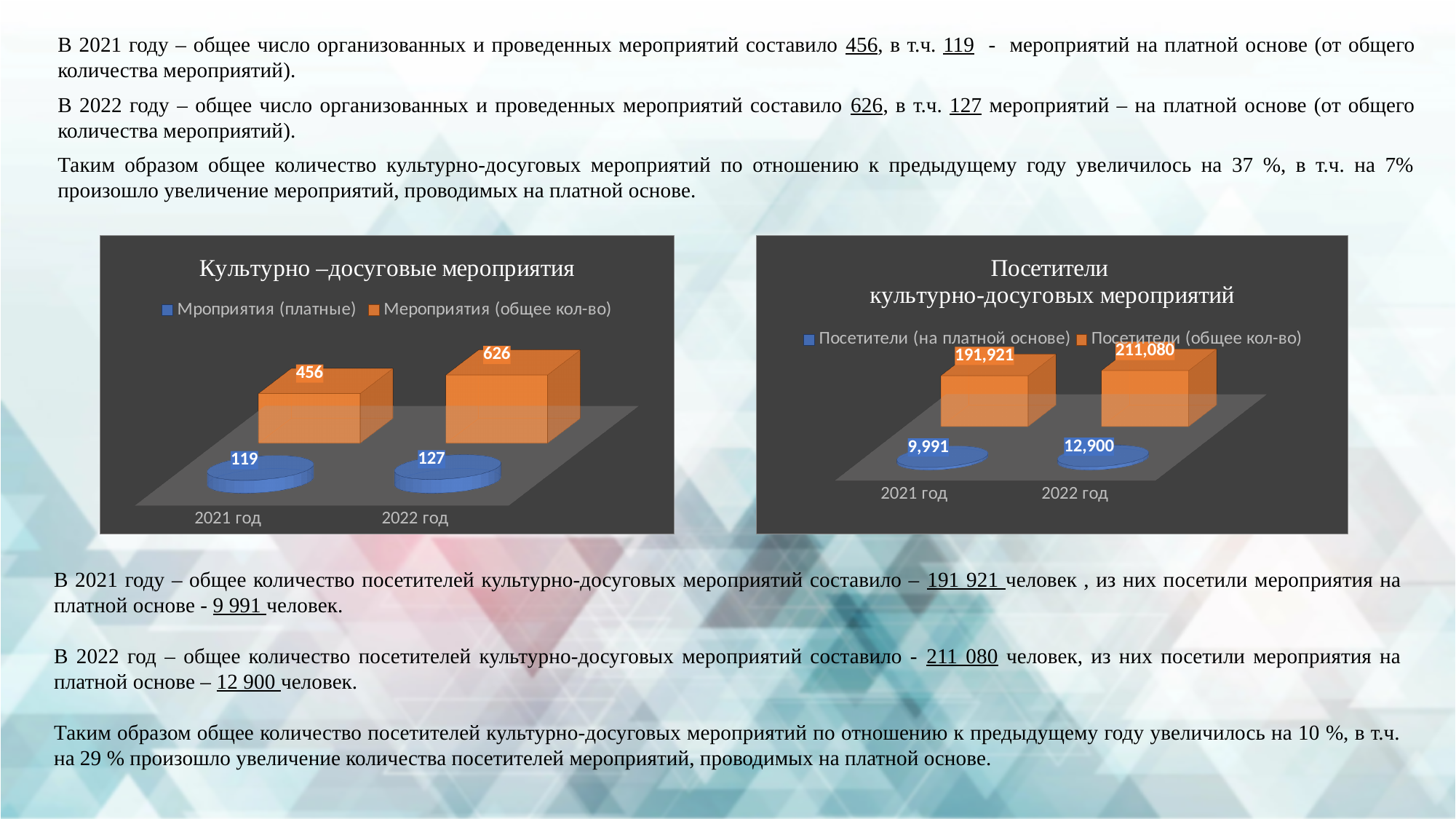
In the chart titled "Культурно –досуговые мероприятия", what is the value for "Мроприятия (платные)" in 2022 год? 127 What kind of chart is the one titled "Культурно –досуговые мероприятия"? bar chart In the chart titled "Культурно –досуговые мероприятия", how many series does the legend list? 2 In the chart titled "Культурно –досуговые мероприятия", by how much did "Мероприятия (общее кол-во)" increase from 2021 год to 2022 год? 170 In the chart titled "Посетители культурно-досуговых мероприятий", what is the value for "Посетители (на платной основе)" in 2021 год? 9,991 In the chart titled "Посетители культурно-досуговых мероприятий", what is the difference between "Посетители (на платной основе)" in 2022 год and in 2021 год? 2,909 In the chart titled "Культурно –досуговые мероприятия", what is the value for "Мероприятия (общее кол-во)" in 2021 год? 456 In the chart titled "Посетители культурно-досуговых мероприятий", which colour represents "Посетители (общее кол-во)"? orange In the chart titled "Посетители культурно-досуговых мероприятий", which year has the higher value for "Посетители (общее кол-во)"? 2022 год In the chart titled "Посетители культурно-досуговых мероприятий", what is the value for "Посетители (общее кол-во)" in 2022 год? 211,080 In the chart titled "Посетители культурно-досуговых мероприятий", how many categories are shown on the x axis? 2 In the chart titled "Культурно –досуговые мероприятия", does the value for "Мроприятия (платные)" rise or fall from 2021 год to 2022 год? rise